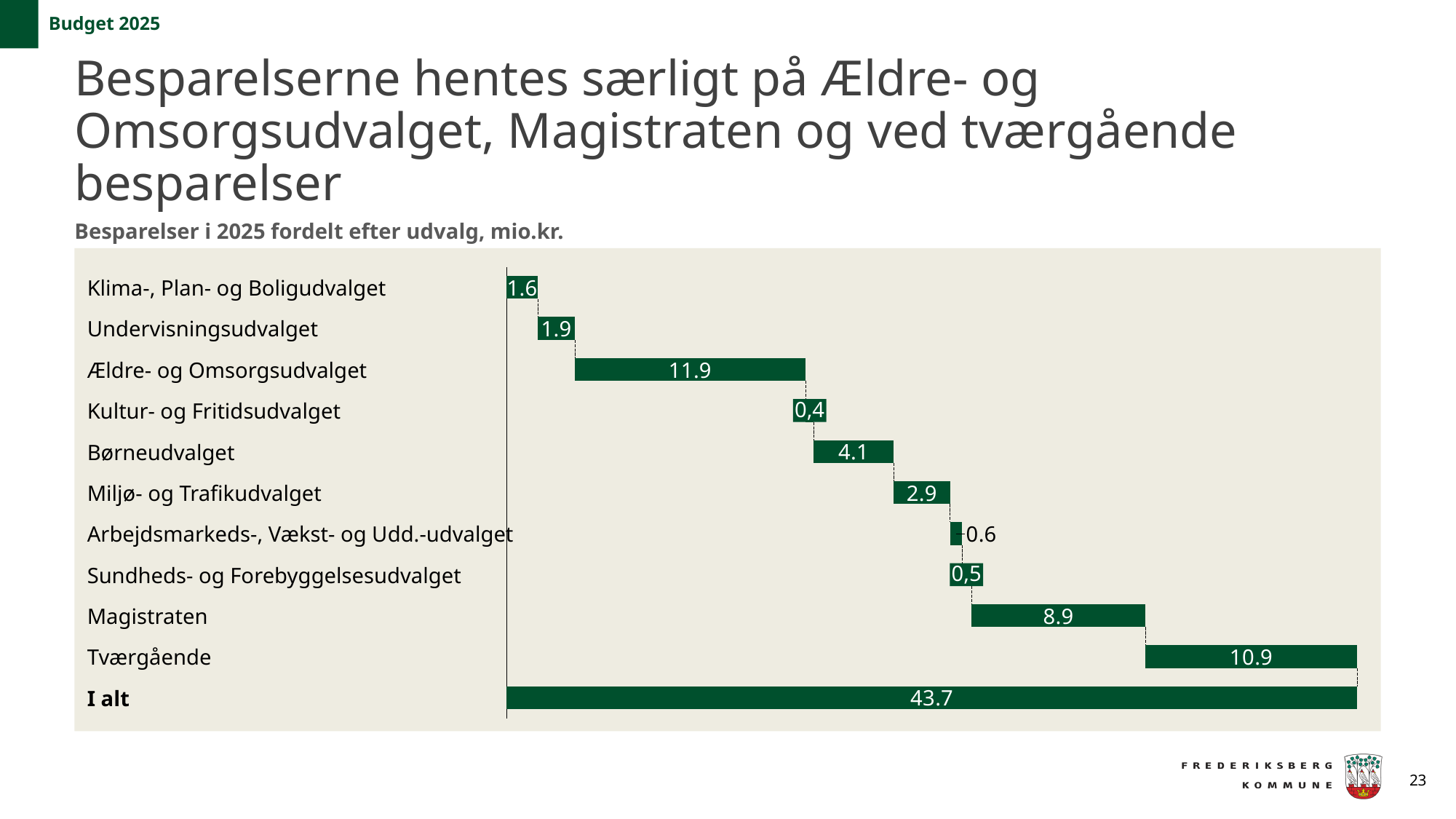
What is the difference between the values for Tværgående and Magistraten? 2.0 What is the value for Kultur- og Fritidsudvalget? 0,4 What is the value for Magistraten? 8.9 Which is larger, the value for Magistraten or the value for Tværgående? Tværgående What is the value shown for I alt? 43.7 What is the difference between the values for Ældre- og Omsorgsudvalget and Tværgående? 1.0 What is the title of the chart? Besparelser i 2025 fordelt efter udvalg, mio.kr. What is the value for Børneudvalget? 4.1 Excluding the I alt total, which committee has the highest value? Ældre- og Omsorgsudvalget Which committee has the lowest value? Kultur- og Fritidsudvalget How many bars are plotted, including the I alt total? 11 What is the value for Ældre- og Omsorgsudvalget? 11.9